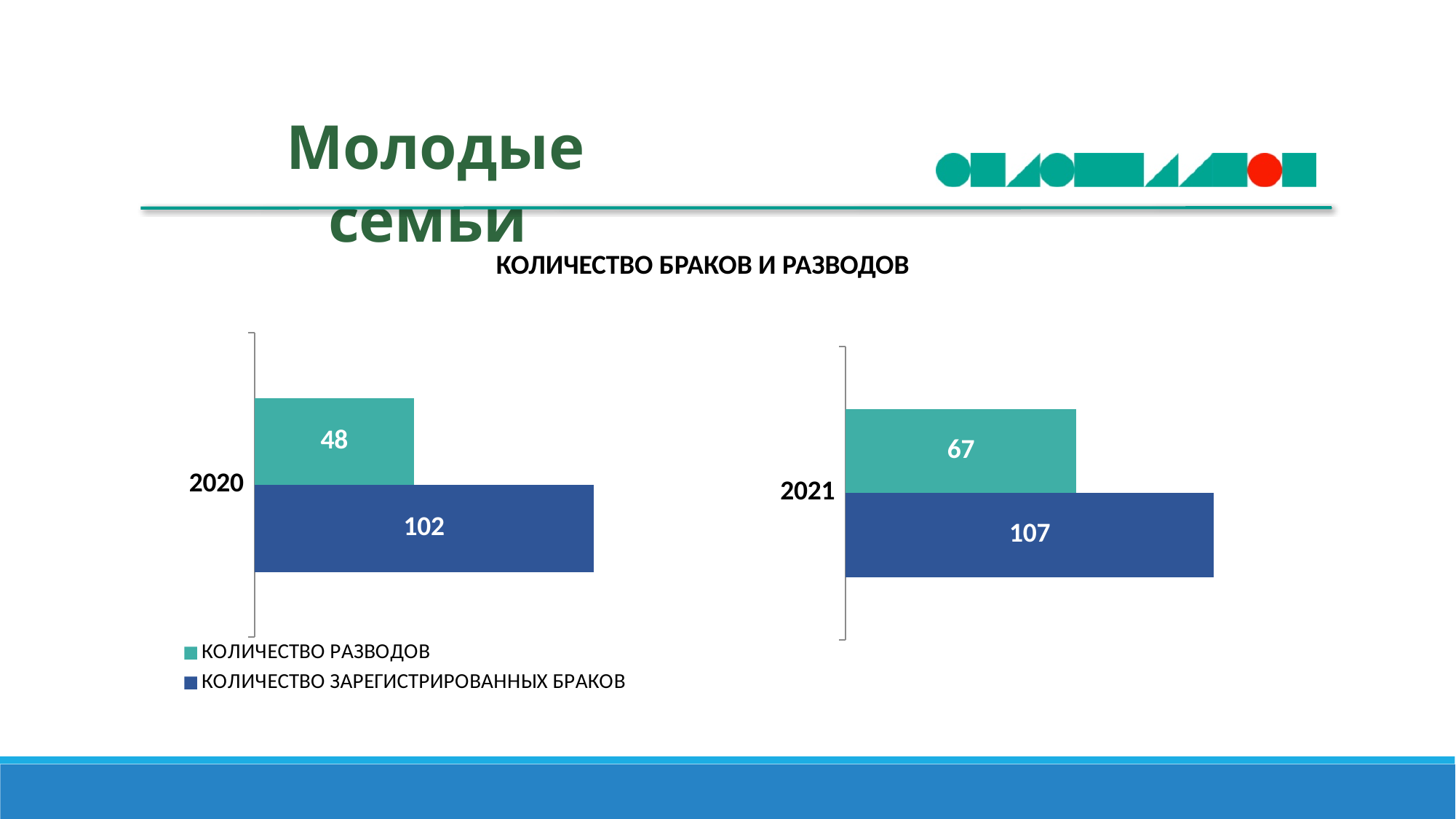
What type of chart is shown on the slide? Bar chart Which year has the lower number of registered marriages? 2020 What is the difference between registered marriages and divorces in 2020? 54 Which year has the higher number of divorces? 2021 What is the title of the chart? КОЛИЧЕСТВО БРАКОВ И РАЗВОДОВ What is the number of registered marriages in 2020? 102 What is the number of divorces (КОЛИЧЕСТВО РАЗВОДОВ) in 2020? 48 What is the number of registered marriages (КОЛИЧЕСТВО ЗАРЕГИСТРИРОВАННЫХ БРАКОВ) in 2021? 107 How many series does the legend list? 2 By how much did the number of divorces increase from 2020 to 2021? 19 What is the number of divorces in 2021? 67 Which is larger in 2021: the number of divorces or the number of registered marriages? Number of registered marriages